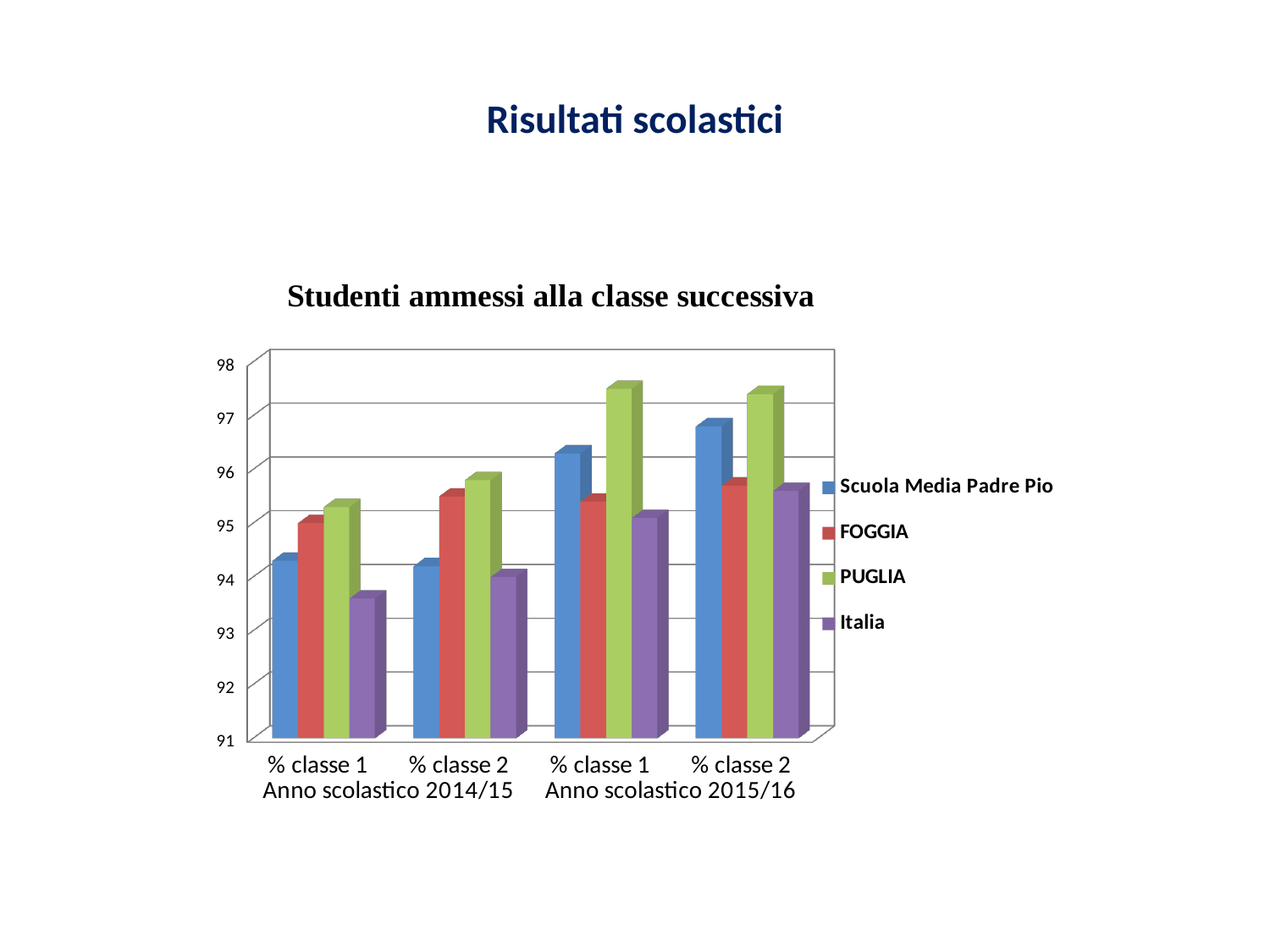
Is the value for Italia in % classe 1 Anno scolastico 2014/15 greater or less than 94? less Which series has the highest value in % classe 1 Anno scolastico 2015/16? PUGLIA How many series does the legend list? 4 Which series has the lowest value in % classe 1 Anno scolastico 2014/15? Italia What is the title of the chart? Studenti ammessi alla classe successiva Does the value for Scuola Media Padre Pio rise or fall from % classe 2 Anno scolastico 2014/15 to % classe 1 Anno scolastico 2015/16? rise Which series is shown in green in the legend? PUGLIA How many categories are shown along the x axis? 4 Is the value for PUGLIA in % classe 1 Anno scolastico 2015/16 greater or less than 97? greater What kind of chart is shown on the slide? bar chart Is the value for Scuola Media Padre Pio in % classe 2 Anno scolastico 2015/16 greater or less than 96? greater In % classe 1 Anno scolastico 2015/16, which is larger: Scuola Media Padre Pio or FOGGIA? Scuola Media Padre Pio